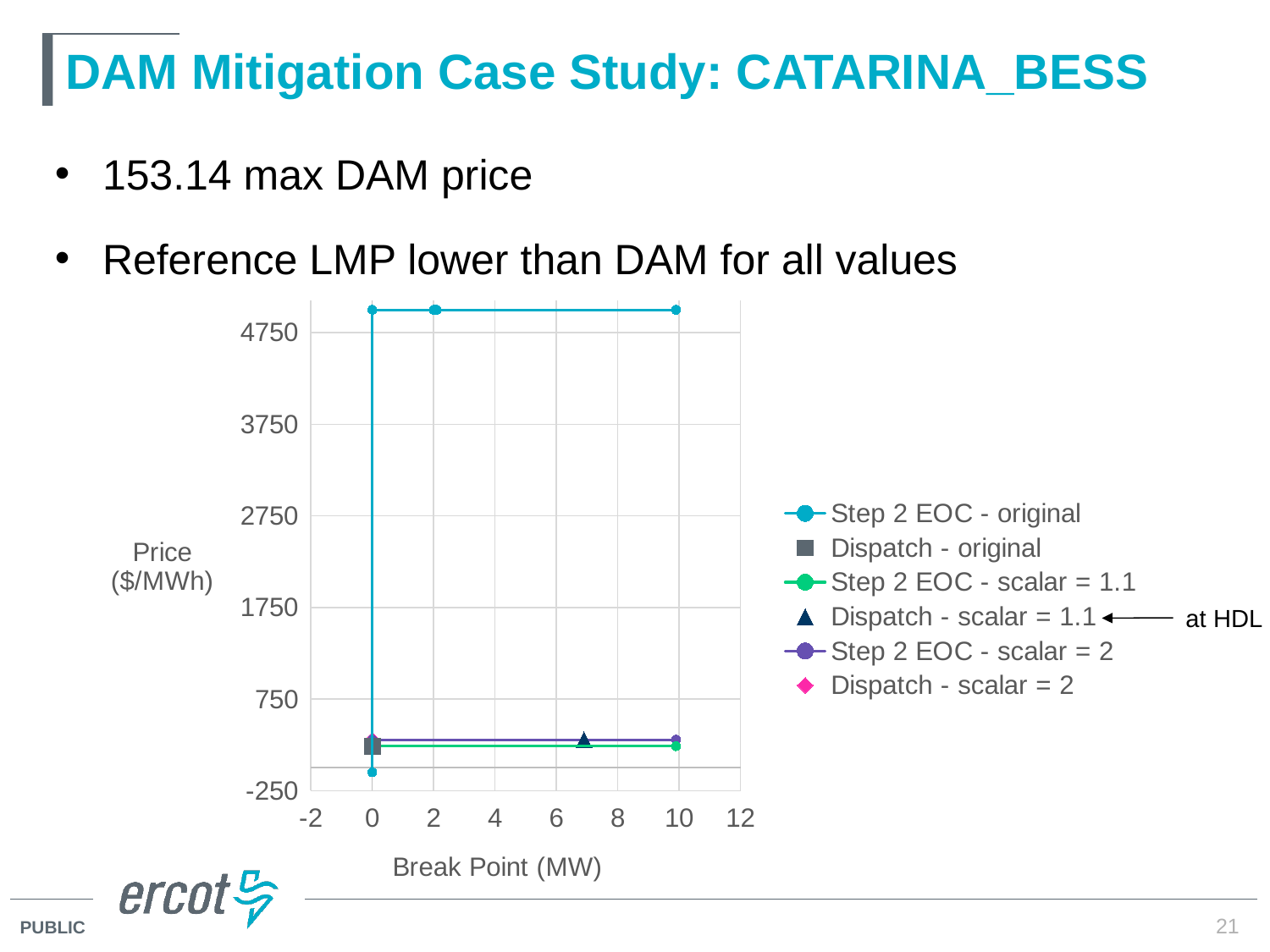
Is the value of Step 2 EOC - scalar = 2 at break point 10 greater or less than 750? less Does the Step 2 EOC - original series rise, fall or stay flat between break point 2 and break point 10? stays flat Is the value of Step 2 EOC - scalar = 1.1 at break point 10 greater or less than 1750? less At break point 10, which series has the higher price: Step 2 EOC - scalar = 2 or Step 2 EOC - scalar = 1.1? Step 2 EOC - scalar = 2 Which series reaches the highest price on the chart? Step 2 EOC - original What kind of chart is shown on the slide? line chart What is the title of the x axis of the chart? Break Point (MW) At break point 10, which series has the higher price: Step 2 EOC - original or Step 2 EOC - scalar = 1.1? Step 2 EOC - original Is the lowest point of the Step 2 EOC - original series greater or less than 750? less How many series does the chart legend list? 6 What is the title of the y axis of the chart? Price ($/MWh)